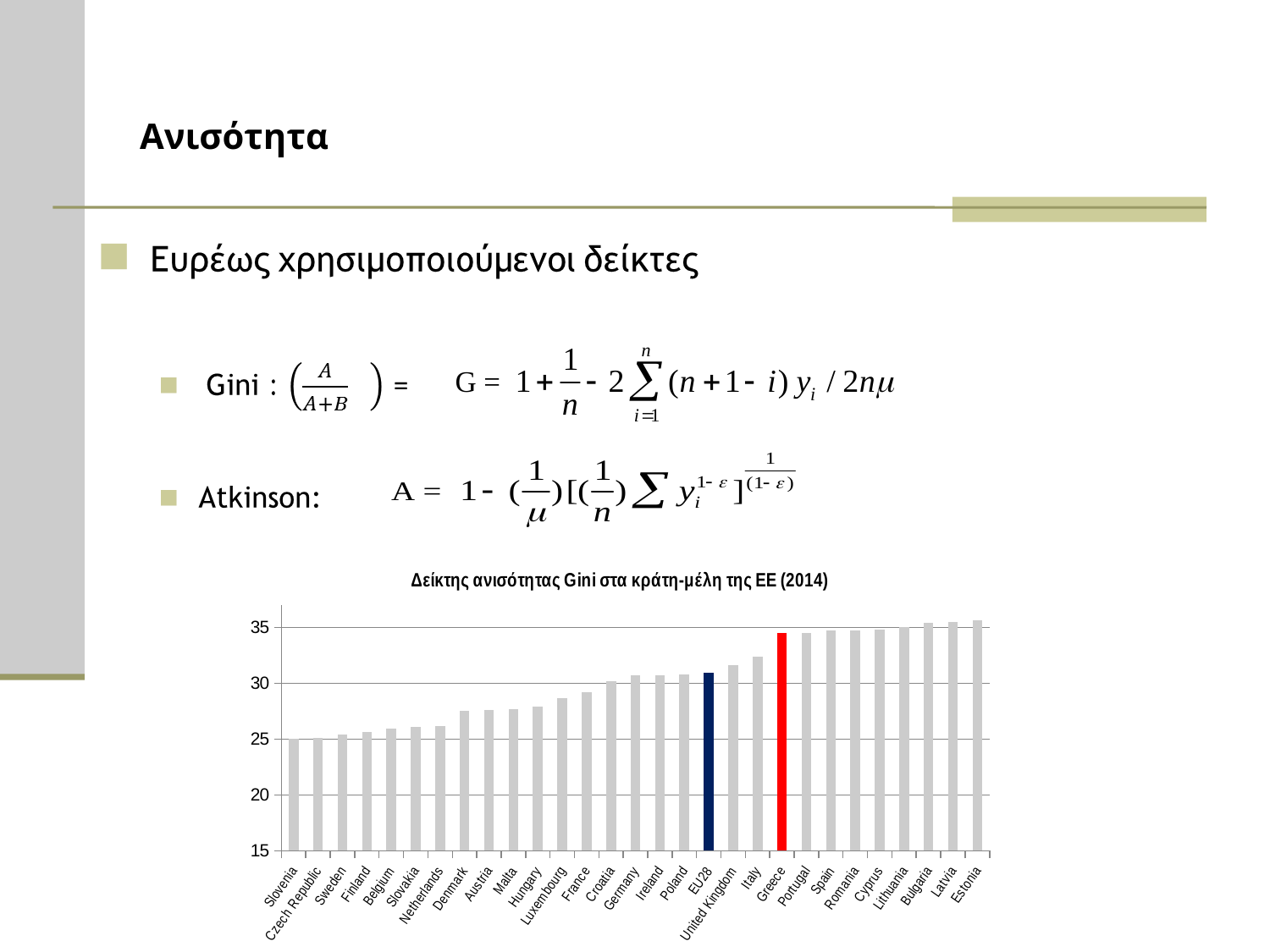
Do the values rise or fall moving from left to right along the x axis? rise Which has the larger value, Sweden or Bulgaria? Bulgaria Is the value for Denmark greater or less than 30? less Is the value for Estonia greater or less than 35? greater What is the title of the chart? Δείκτης ανισότητας Gini στα κράτη-μέλη της ΕΕ (2014) How many bars (countries/groups) are plotted in the chart? 29 What colour is the bar for Greece? red Which has the larger value, Greece or EU28? Greece Is the value for Greece greater or less than 35? less What kind of chart is shown on the slide? bar chart